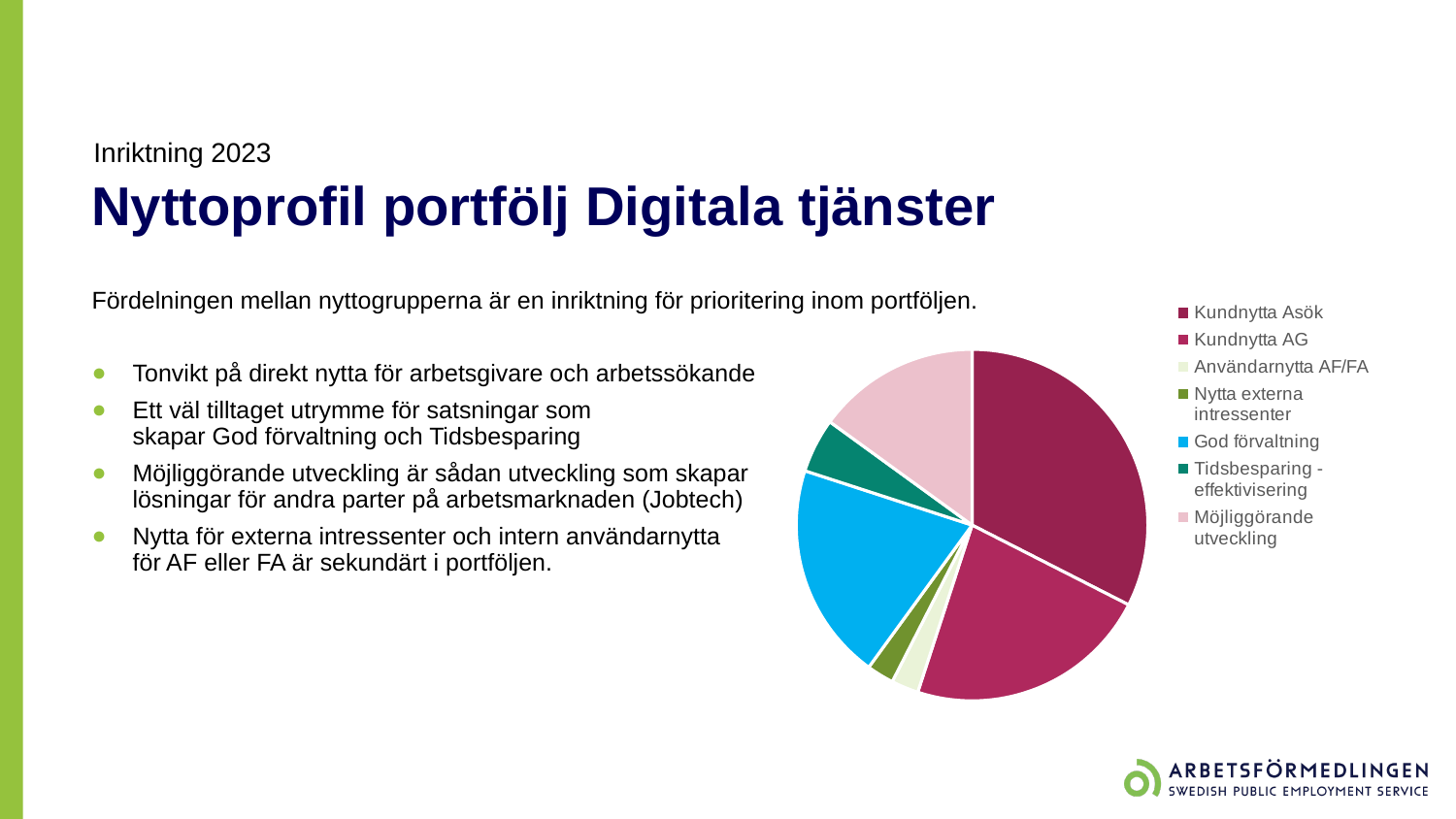
Which slice is larger, Kundnytta AG or Tidsbesparing - effektivisering? Kundnytta AG Which slice is larger, God förvaltning or Möjliggörande utveckling? God förvaltning Which legend entry is listed first in the pie chart's legend? Kundnytta Asök How many categories does the pie chart's legend list? 7 What colour is the God förvaltning slice in the pie chart? Light blue Which slice is larger, Kundnytta AG or Nytta externa intressenter? Kundnytta AG What kind of chart is shown on the slide? Pie chart Which category has the largest slice of the pie chart? Kundnytta Asök